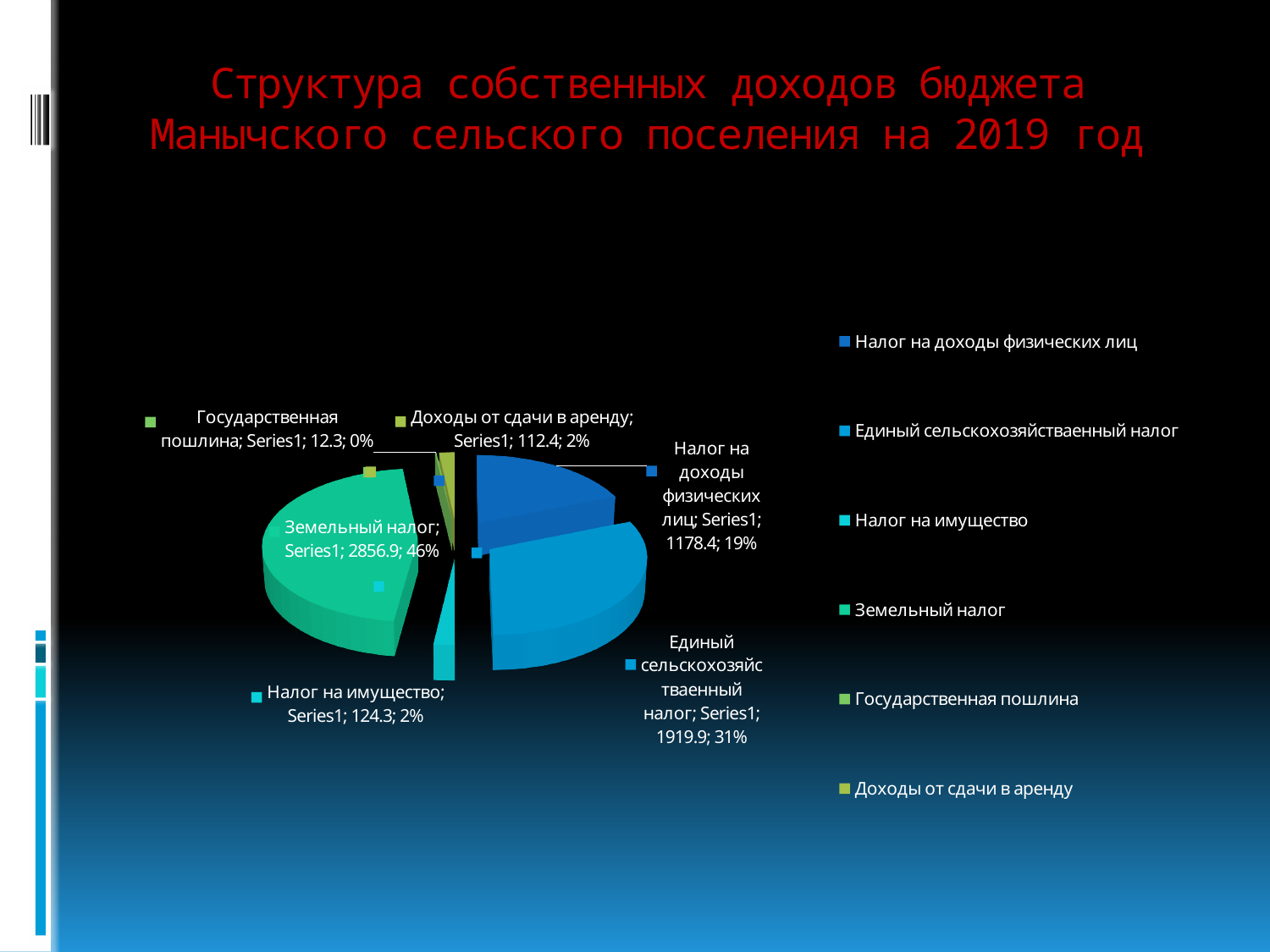
What is the value for Земельный налог? 2856.9 What is the difference between the values for Налог на имущество and Доходы от сдачи в аренду? 11.9 What is the difference between the values for Земельный налог and Единый сельскохозяйстваенный налог? 937.0 What is the title of the slide containing the chart? Структура собственных доходов бюджета Манычского сельского поселения на 2019 год What share of the pie does Государственная пошлина represent? 0% What type of chart is shown on the slide? Pie chart How many categories does the pie chart have? 6 Which is larger: the value for Налог на имущество or the value for Доходы от сдачи в аренду? Налог на имущество What share of the pie does Единый сельскохозяйстваенный налог represent? 31% Which category has the largest slice of the pie? Земельный налог Which category has the smallest slice of the pie? Государственная пошлина What is the value for Налог на доходы физических лиц? 1178.4